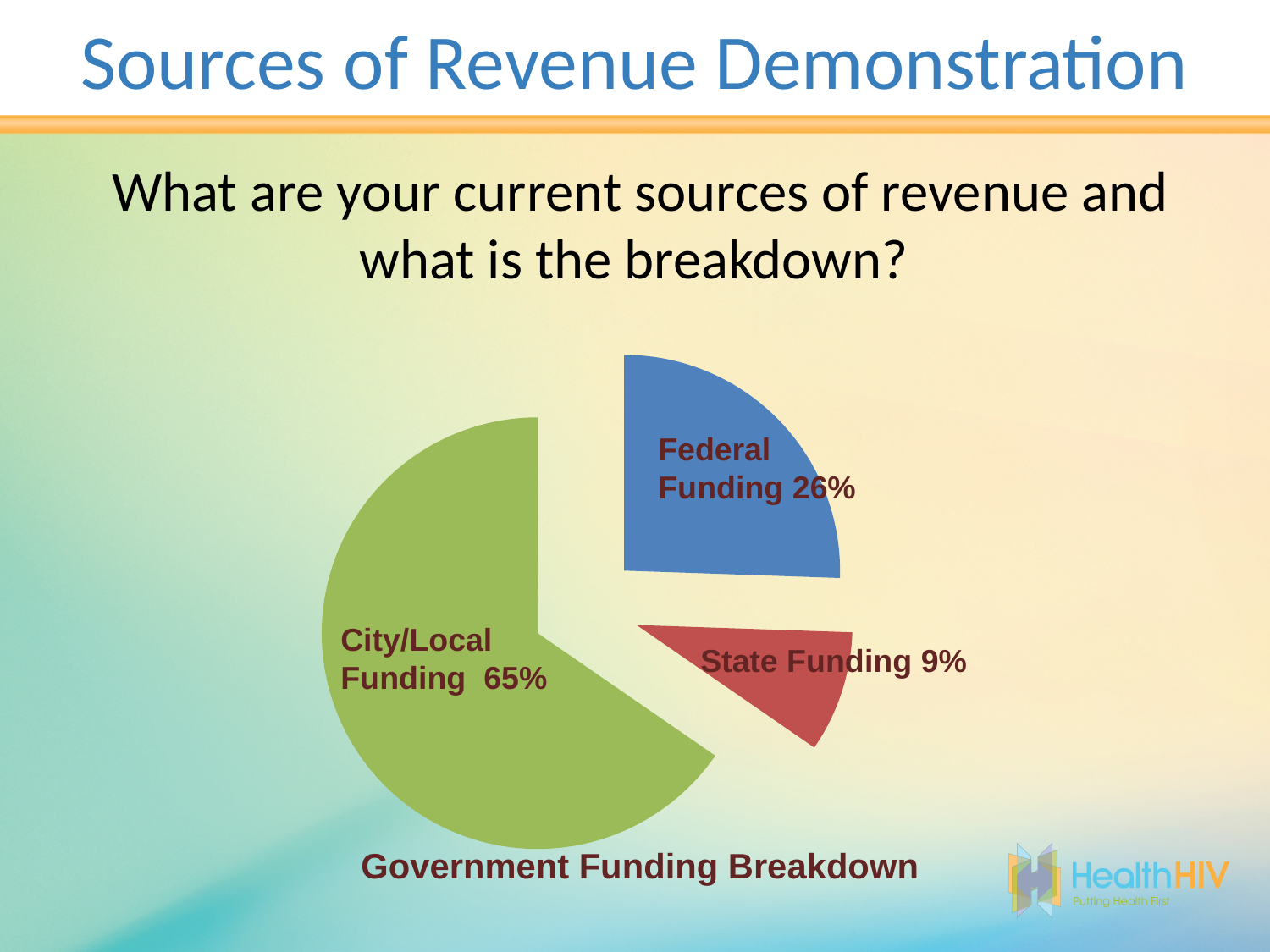
What colour is the City/Local Funding slice? Green Which funding source has the largest share of the pie? City/Local Funding What share of the pie is Federal Funding? 26% What is the difference in percentage points between Federal Funding and State Funding? 17 What is the difference in percentage points between City/Local Funding and Federal Funding? 39 What share of the pie is State Funding? 9% Which funding source has the smallest share of the pie? State Funding Which is larger, Federal Funding or State Funding? Federal Funding What share of the pie is City/Local Funding? 65% What is the title of the chart? Government Funding Breakdown What kind of chart is shown on the slide? Pie chart How many slices does the pie chart have? 3